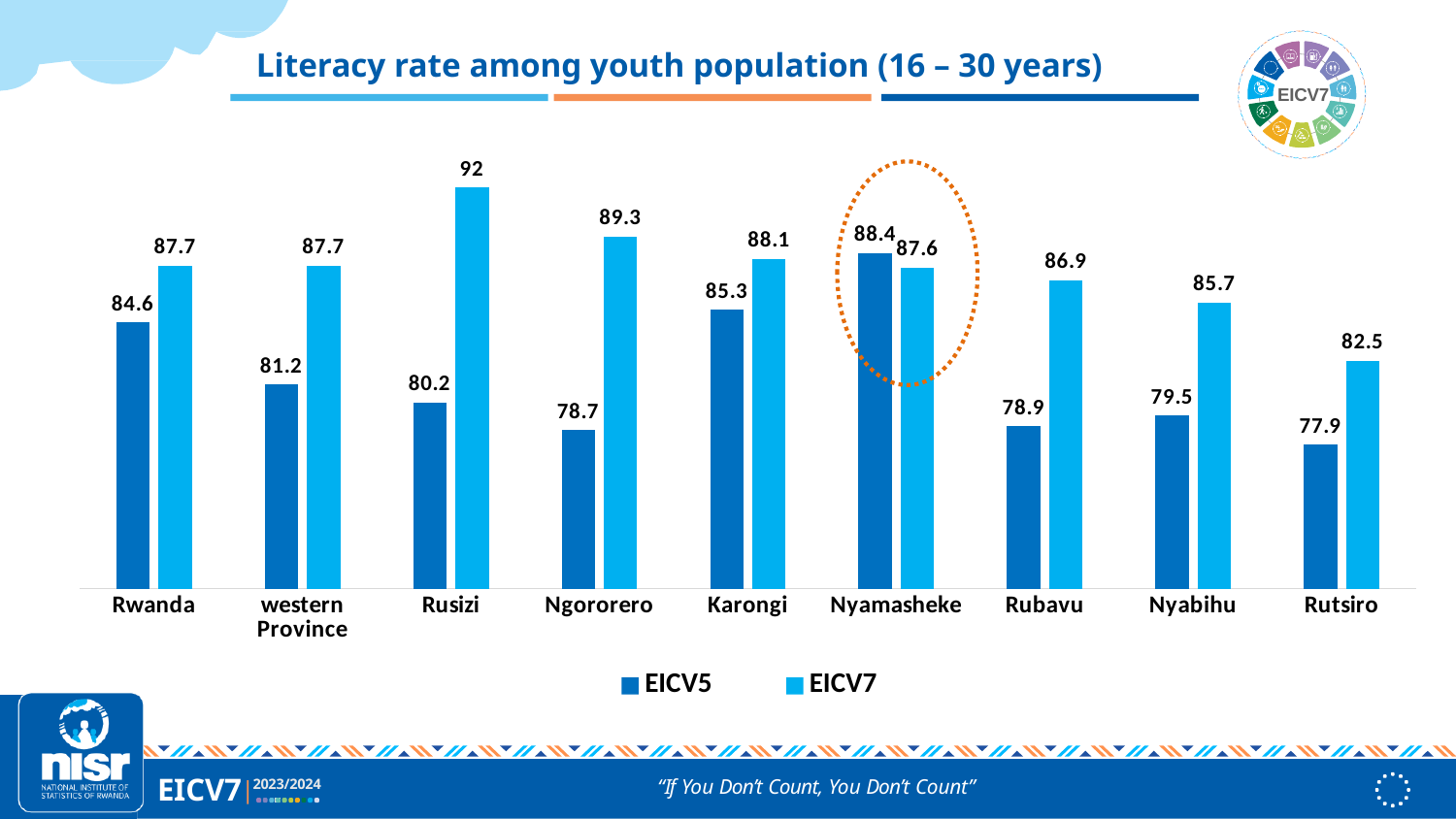
Which category has the highest EICV5 value? Nyamasheke Which category has the lowest EICV5 value? Rutsiro What is the EICV5 literacy rate for Nyamasheke? 88.4 How many series does the legend list? 2 What is the difference between the EICV7 and EICV5 values for Rusizi? 11.8 What is the difference between the EICV7 and EICV5 values for Ngororero? 10.6 How many categories are shown on the x axis? 9 What is the EICV7 literacy rate for Rusizi? 92 Which category has the highest EICV7 value? Rusizi What is the EICV7 literacy rate for Rutsiro? 82.5 What kind of chart is shown on the slide? Bar chart For Nyamasheke, which is larger: the EICV5 value or the EICV7 value? EICV5